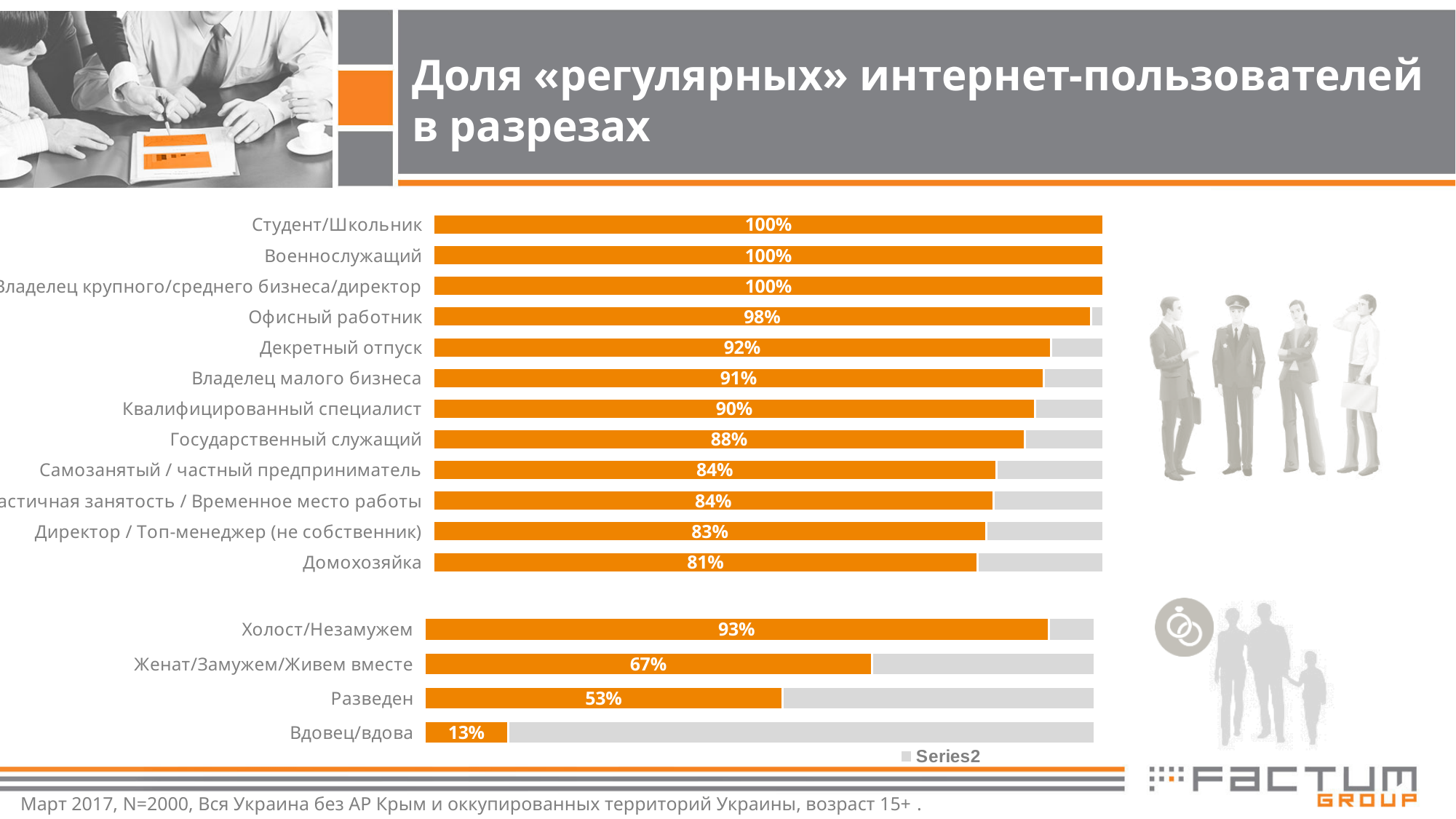
What type of chart is used on this slide? Bar chart How many categories are shown in the upper chart (occupation)? 12 In the upper chart (occupation), which is larger: Владелец малого бизнеса or Директор / Топ-менеджер (не собственник)? Владелец малого бизнеса In the upper chart (occupation), what is the value for Офисный работник? 98% In the upper chart (occupation), which category has the lowest value? Домохозяйка In the lower chart (marital status), what is the difference between Холост/Незамужем and Женат/Замужем/Живем вместе? 26% In the upper chart (occupation), what is the difference between Декретный отпуск and Государственный служащий? 4% In the lower chart (marital status), which category has the lowest value? Вдовец/вдова In the lower chart (marital status), what is the value for Разведен? 53% In the upper chart (occupation), what is the value for Домохозяйка? 81% How many categories are shown in the lower chart (marital status)? 4 In the lower chart (marital status), which category has the highest value? Холост/Незамужем